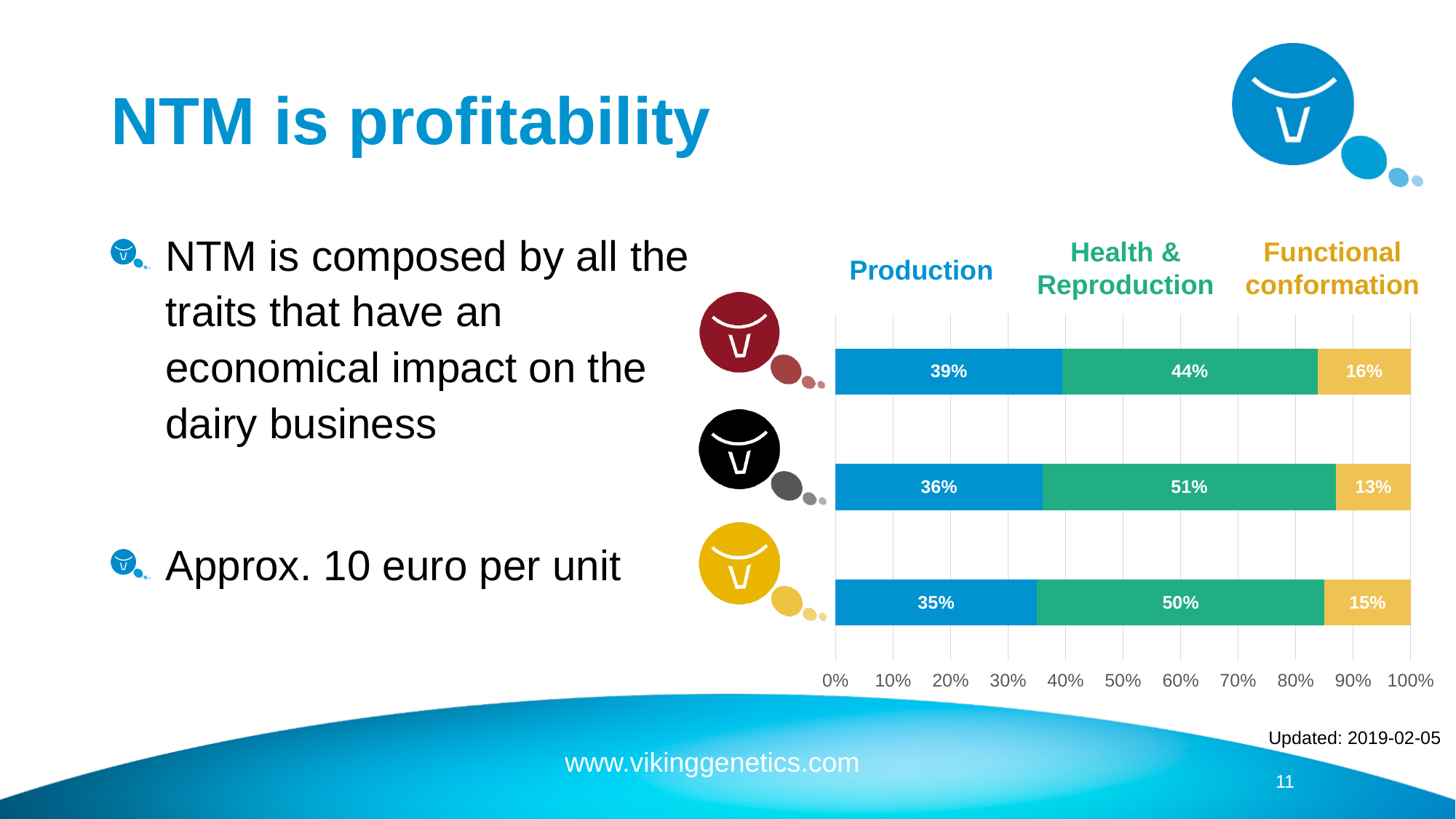
What is the Functional conformation share in the bottom bar (yellow logo)? 15% What is the total of the three segments in the top bar? 99% What colour represents the Health & Reproduction series? green What is the Production share in the top bar (red logo)? 39% Which bar has the lowest Functional conformation share? the middle bar (black logo) Which is larger: the Production share in the top bar or in the bottom bar? the top bar (39%) How many bars are plotted in the chart? 3 What kind of chart is shown on the slide? bar chart What is the Health & Reproduction share in the middle bar (black logo)? 51% How many series does the chart show? 3 Which bar has the highest Health & Reproduction share? the middle bar (black logo) What is the difference between the Health & Reproduction share in the middle bar (51%) and in the top bar (44%)? 7%